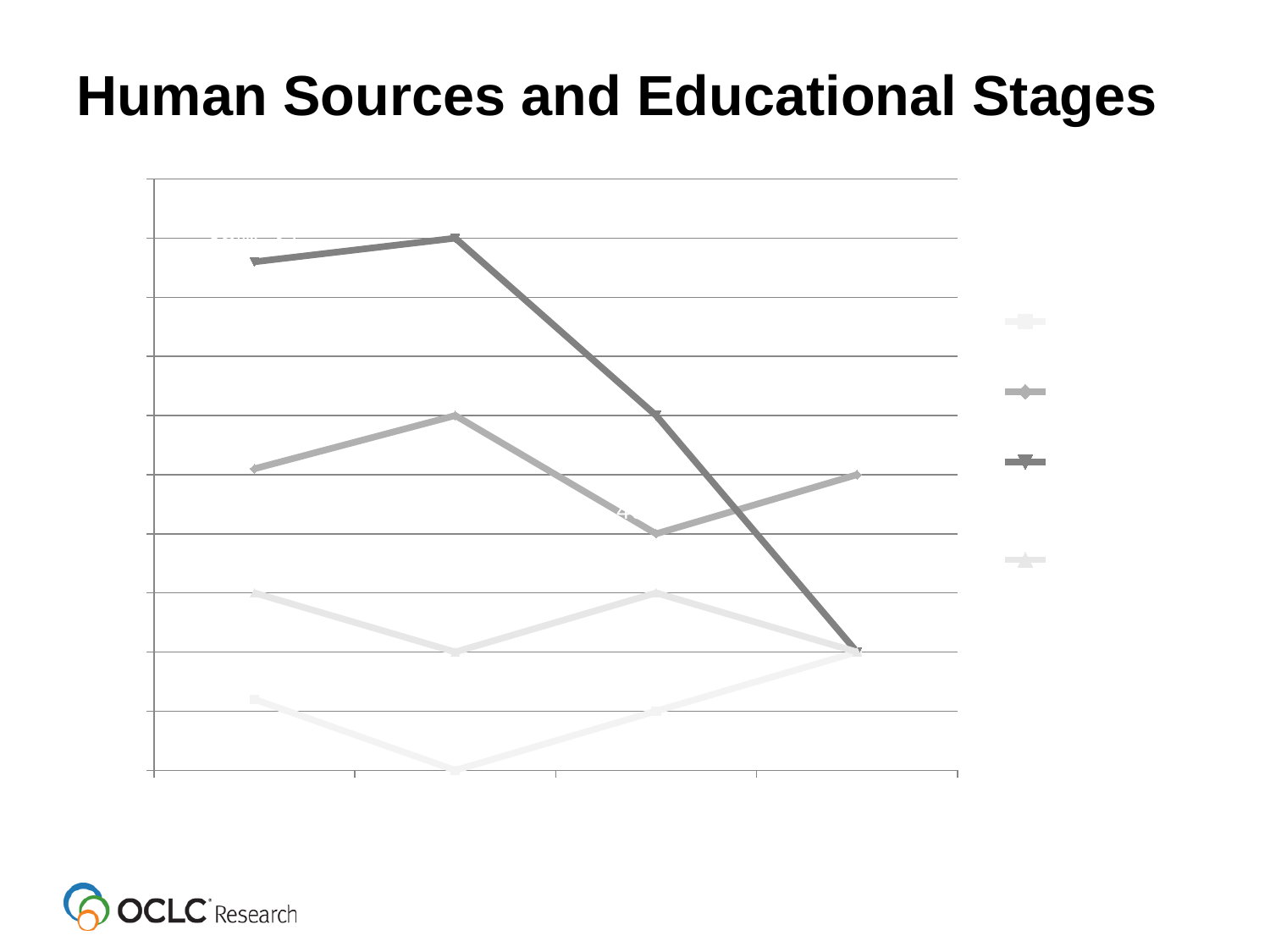
How many lines are plotted on the chart? 4 How many data points does each line have along the x axis? 4 Does the lightest line rise or fall between its first and second points? fall Which line is highest at the first x-axis position? the darkest grey line From its second point to its last point, does the darkest grey line rise or fall? fall What is the title of the slide containing the chart? Human Sources and Educational Stages What kind of chart is shown on the slide? line chart How many series does the legend list? 4 At the last x-axis position, which is higher: the darkest grey line or the medium grey line? the medium grey line Which line is lowest at the first x-axis position? the lightest (near-white) line Does the darkest grey line end higher or lower than it starts? lower